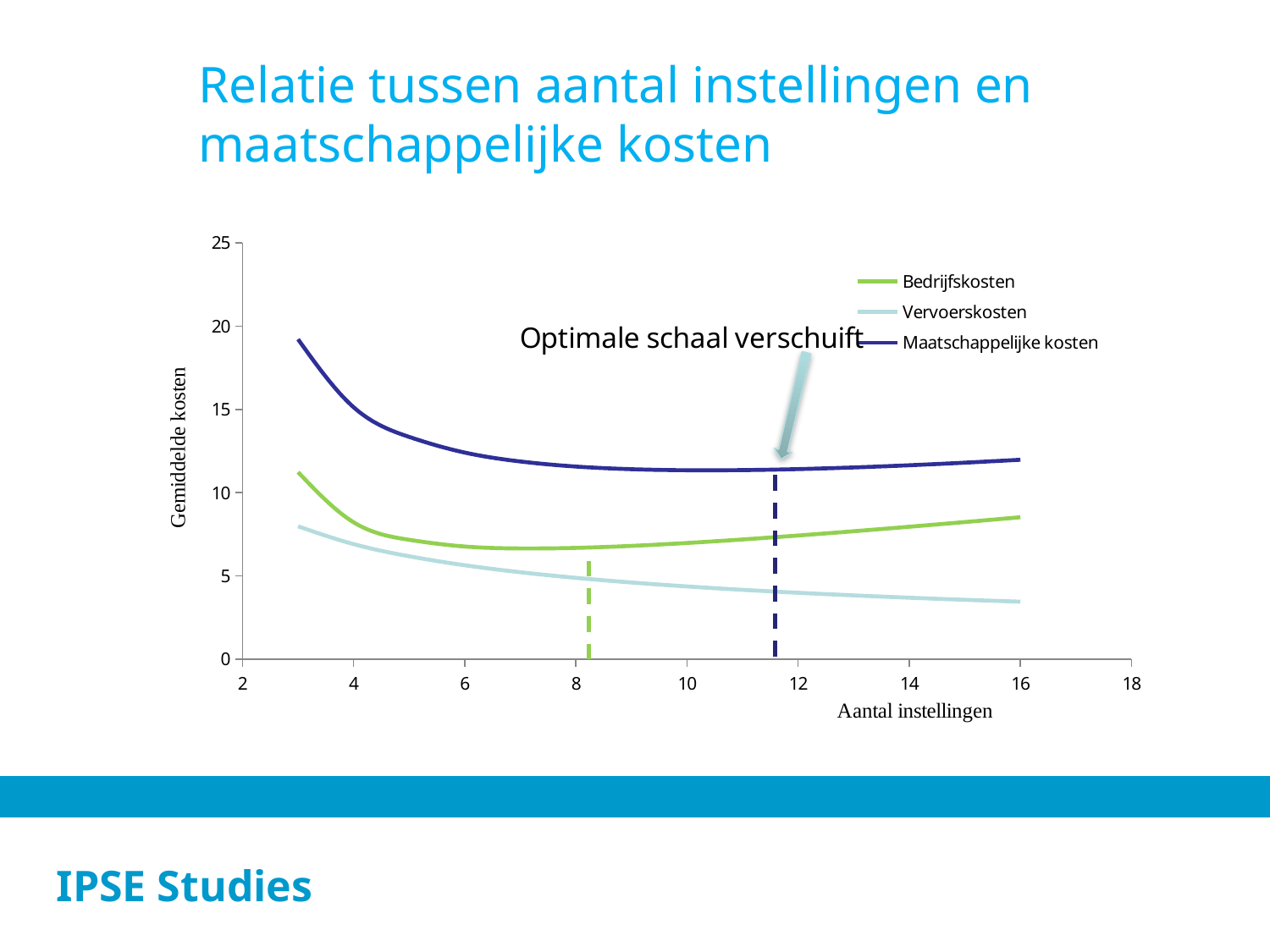
Is the value for Bedrijfskosten at 16 institutions greater or less than 10? less Is the value for Maatschappelijke kosten at 3 institutions greater or less than 15? greater What kind of chart is shown on the slide? line chart What is the label of the x axis? Aantal instellingen Which series has the highest values across the whole x axis? Maatschappelijke kosten Do the values for Vervoerskosten rise or fall as the number of institutions increases along the x axis? fall Which series are listed in the legend? Bedrijfskosten, Vervoerskosten, Maatschappelijke kosten How many series does the legend list? 3 Is the value for Maatschappelijke kosten at 16 institutions greater or less than 10? greater Which series has the lowest value at 16 institutions? Vervoerskosten At 10 institutions, which is larger: Maatschappelijke kosten or Bedrijfskosten? Maatschappelijke kosten